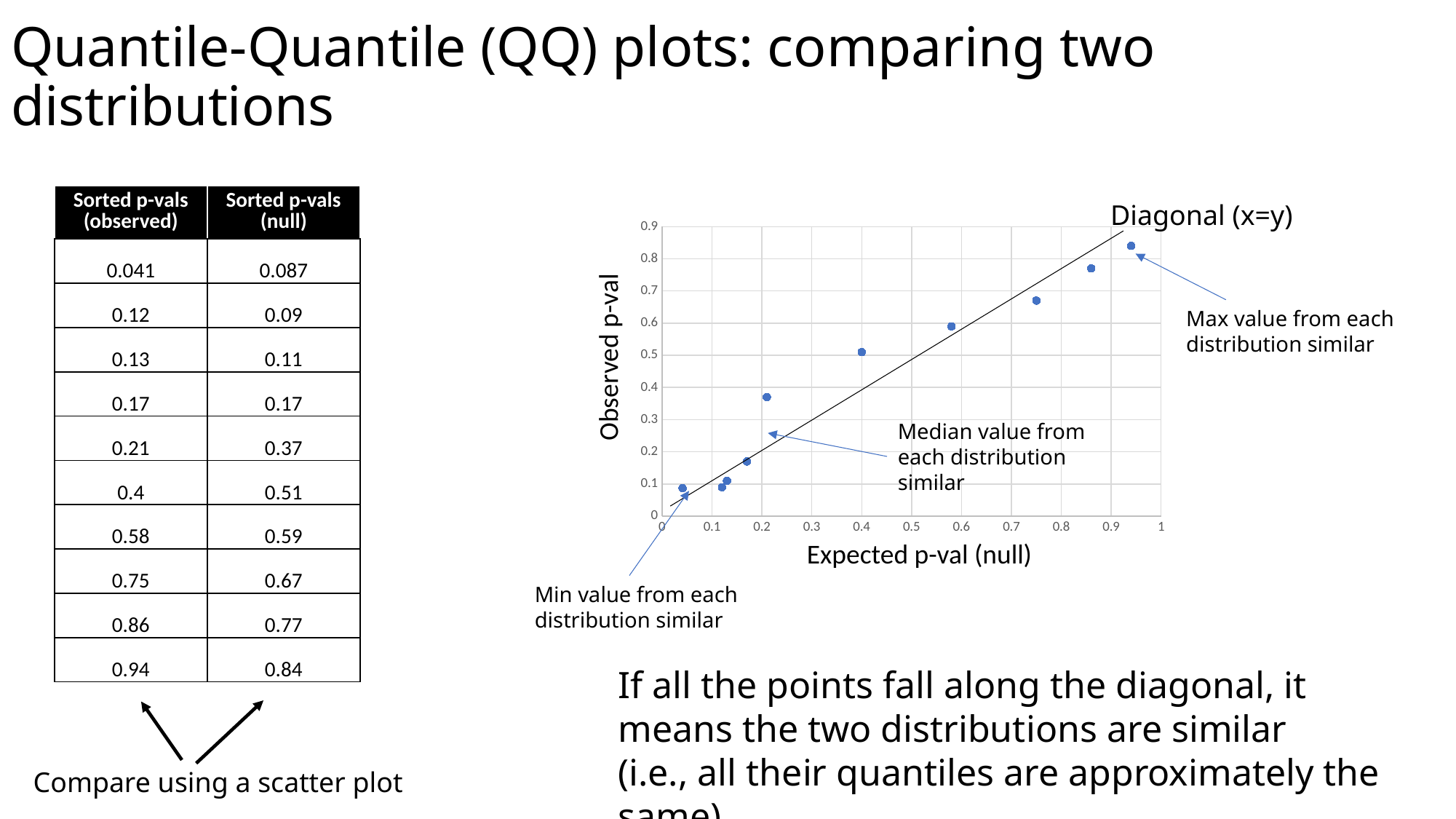
Does the rightmost point in the scatter plot lie above or below the diagonal line? below What is the title of the x axis of the scatter plot? Expected p-val (null) Is the y value of the point plotted at about x = 0.2 greater or less than 0.3? greater What is the title of the y axis of the scatter plot? Observed p-val Is the y value of the point plotted at about x = 0.86 greater or less than 0.8? less Do the plotted points generally rise or fall as the x value increases? rise Is the y value of the point plotted at about x = 0.75 greater or less than 0.7? less What kind of chart is shown on the slide? scatter plot Does the point plotted at about x = 0.2 lie above or below the diagonal line? above How many data points are plotted in the scatter plot? 10